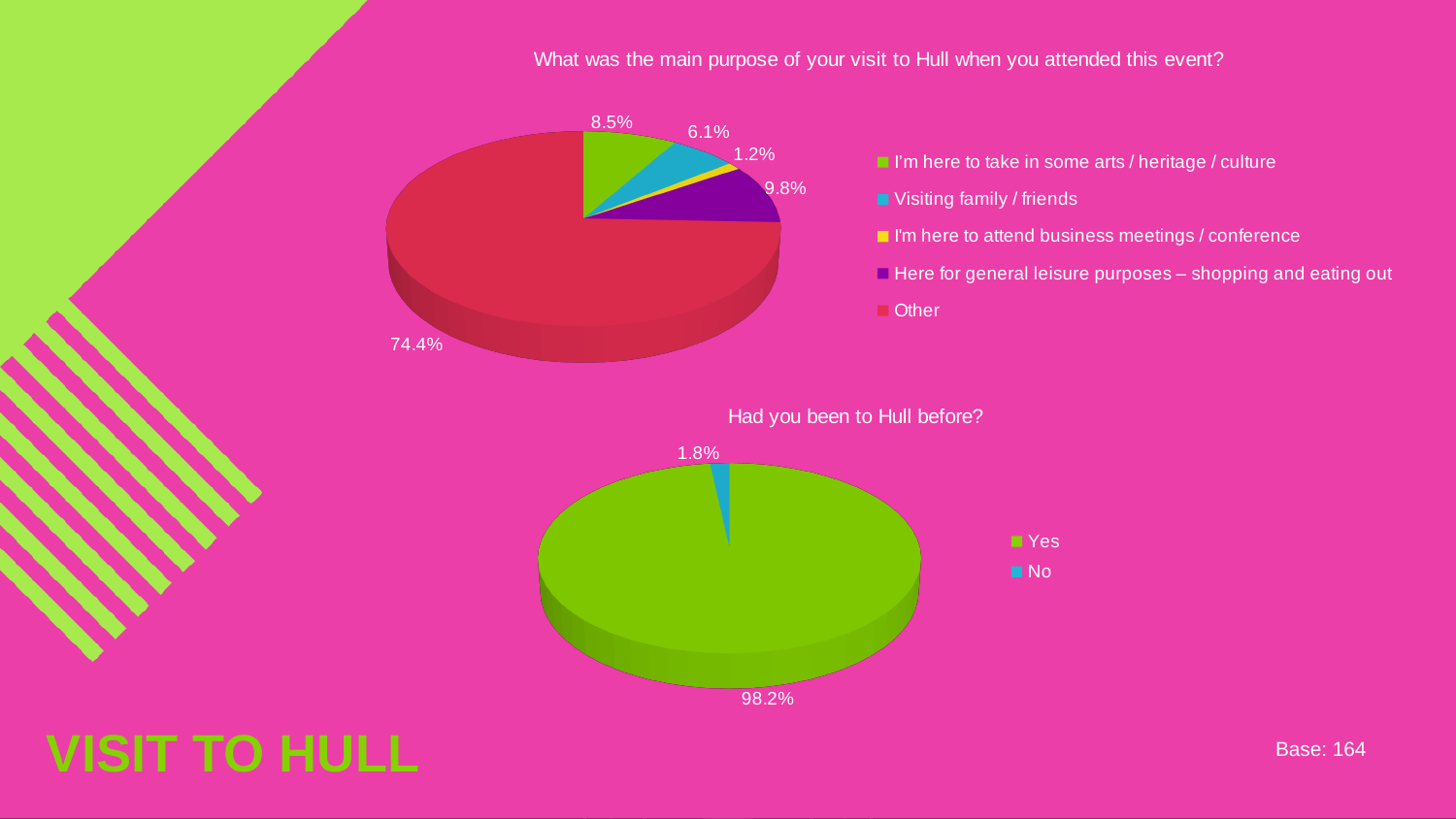
In the chart titled 'Had you been to Hull before?', what colour represents 'No'? Blue In the chart titled 'What was the main purpose of your visit to Hull when you attended this event?', which is larger: the share for arts / heritage / culture or the share for general leisure purposes? Here for general leisure purposes – shopping and eating out In the chart titled 'What was the main purpose of your visit to Hull when you attended this event?', what share of respondents answered 'Other'? 74.4% In the chart titled 'What was the main purpose of your visit to Hull when you attended this event?', what is the difference in percentage points between 'Here for general leisure purposes – shopping and eating out' and 'Visiting family / friends'? 3.7 percentage points In the chart titled 'What was the main purpose of your visit to Hull when you attended this event?', which category has the smallest share? I'm here to attend business meetings / conference What type of chart is used for 'Had you been to Hull before?'? Pie chart In the chart titled 'What was the main purpose of your visit to Hull when you attended this event?', which category has the largest share? Other In the chart titled 'Had you been to Hull before?', what percentage answered 'No'? 1.8% In the chart titled 'What was the main purpose of your visit to Hull when you attended this event?', what percentage were visiting family / friends? 6.1% In the chart titled 'What was the main purpose of your visit to Hull when you attended this event?', what percentage said they were here to take in some arts / heritage / culture? 8.5% In the chart titled 'Had you been to Hull before?', what percentage answered 'Yes'? 98.2% How many categories does the legend list for the chart titled 'What was the main purpose of your visit to Hull when you attended this event?'? 5